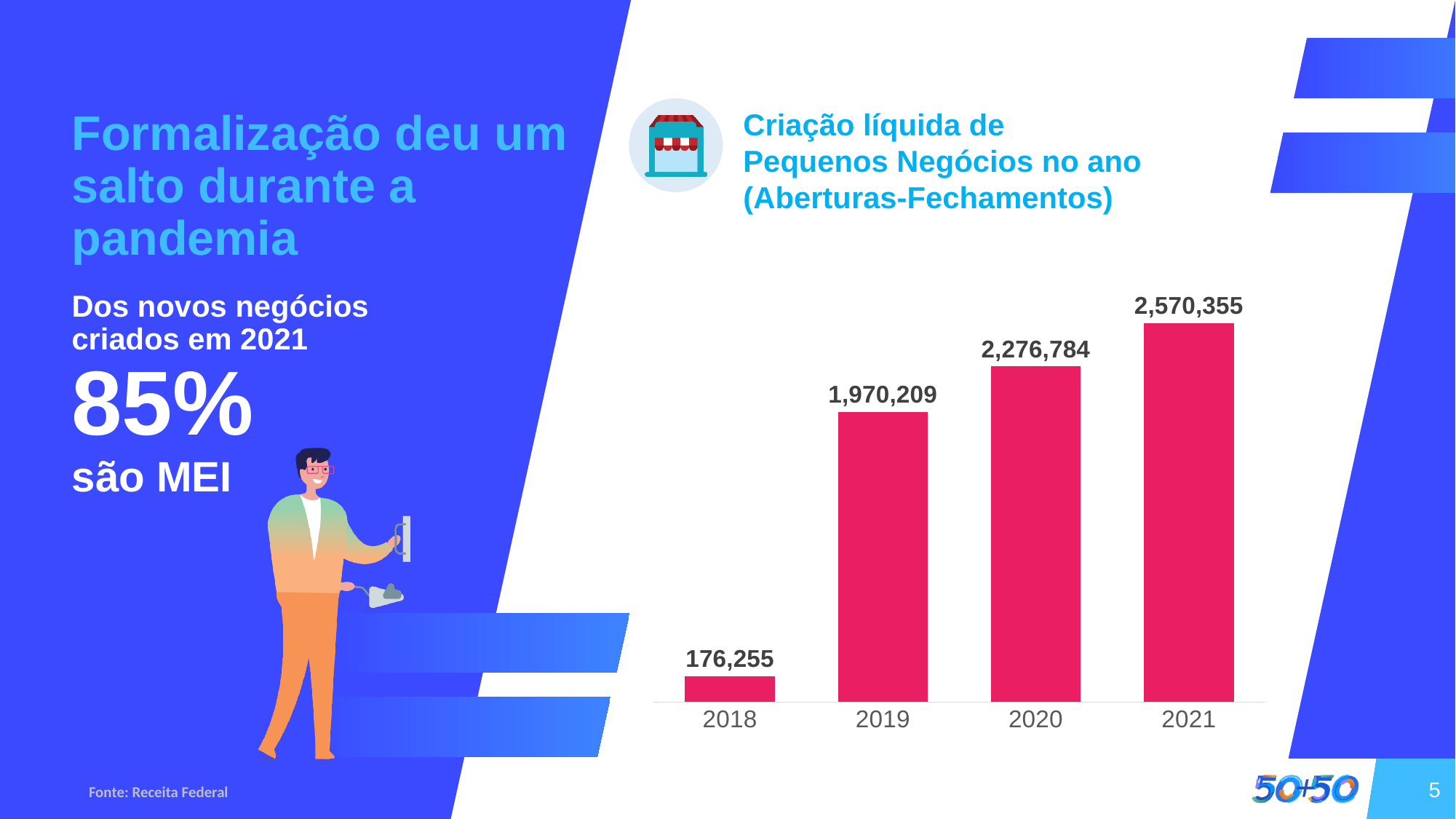
What is the difference between the values for 2019 and 2018? 1,793,954 Which is larger, the value for 2019 or the value for 2020? 2020 How many years are shown on the x axis? 4 Which year has the lowest value? 2018 What is the difference between the values for 2021 and 2020? 293,571 Do the values rise or fall from 2018 to 2021? Rise Which year has the highest value? 2021 What is the value for 2019? 1,970,209 What kind of chart is shown on the slide? Bar chart What is the value for 2021? 2,570,355 What is the value for 2018? 176,255 What is the value for 2020? 2,276,784